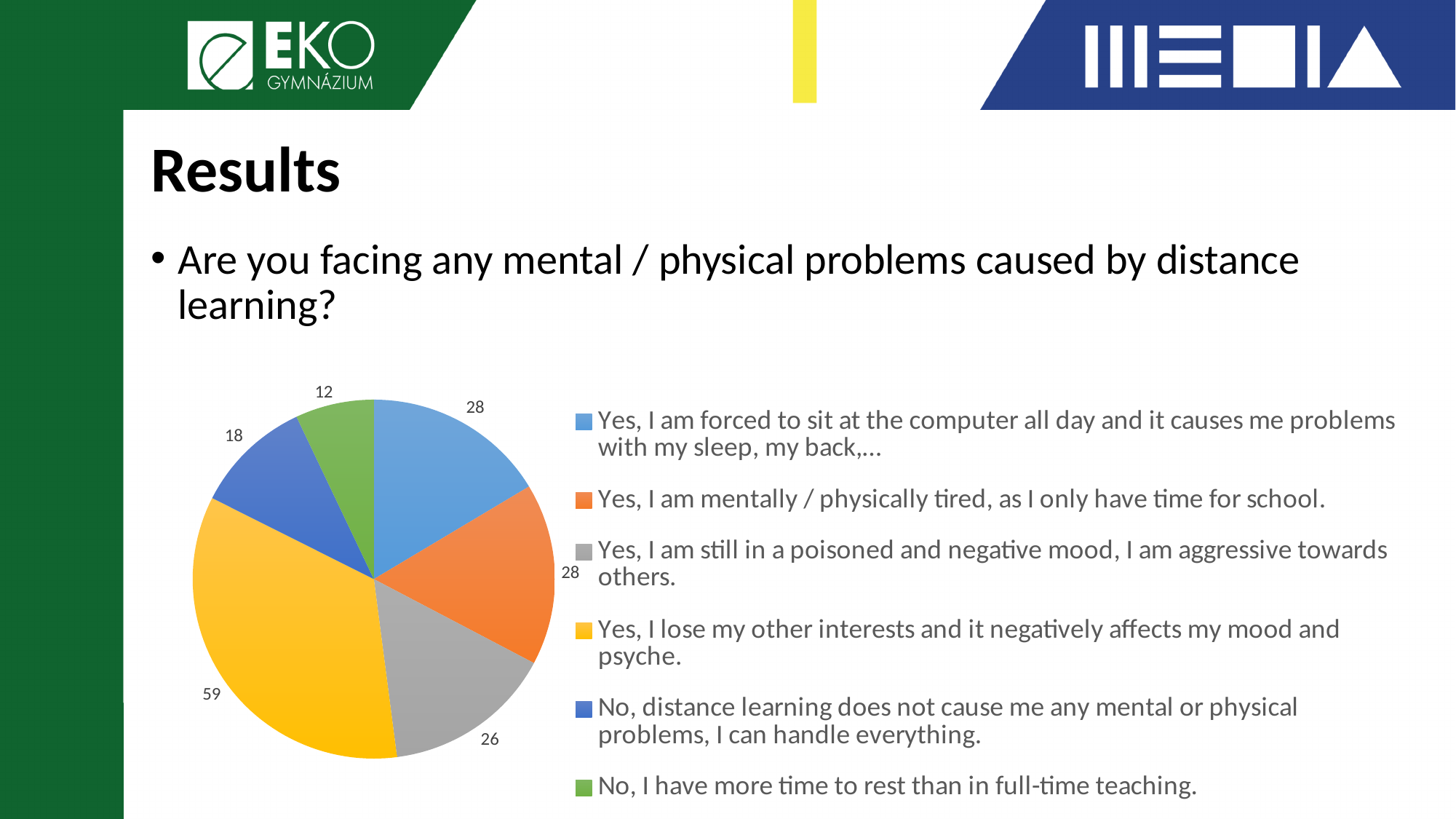
What is the total of all the values shown on the pie chart? 171 Which is larger: the value for "Yes, I am still in a poisoned and negative mood, I am aggressive towards others." or the value for "No, distance learning does not cause me any mental or physical problems, I can handle everything."? Yes, I am still in a poisoned and negative mood, I am aggressive towards others. What colour is the slice for "Yes, I lose my other interests and it negatively affects my mood and psyche."? yellow What is the value for "No, I have more time to rest than in full-time teaching."? 12 What is the value for "No, distance learning does not cause me any mental or physical problems, I can handle everything."? 18 What kind of chart is shown on the slide? pie chart What is the difference between the value for "Yes, I lose my other interests and it negatively affects my mood and psyche." and the value for "No, distance learning does not cause me any mental or physical problems, I can handle everything."? 41 Which response has the largest slice of the pie? Yes, I lose my other interests and it negatively affects my mood and psyche. What is the value for "Yes, I lose my other interests and it negatively affects my mood and psyche."? 59 How many slices does the pie chart have? 6 What is the value for "Yes, I am still in a poisoned and negative mood, I am aggressive towards others."? 26 Which response has the smallest slice of the pie? No, I have more time to rest than in full-time teaching.